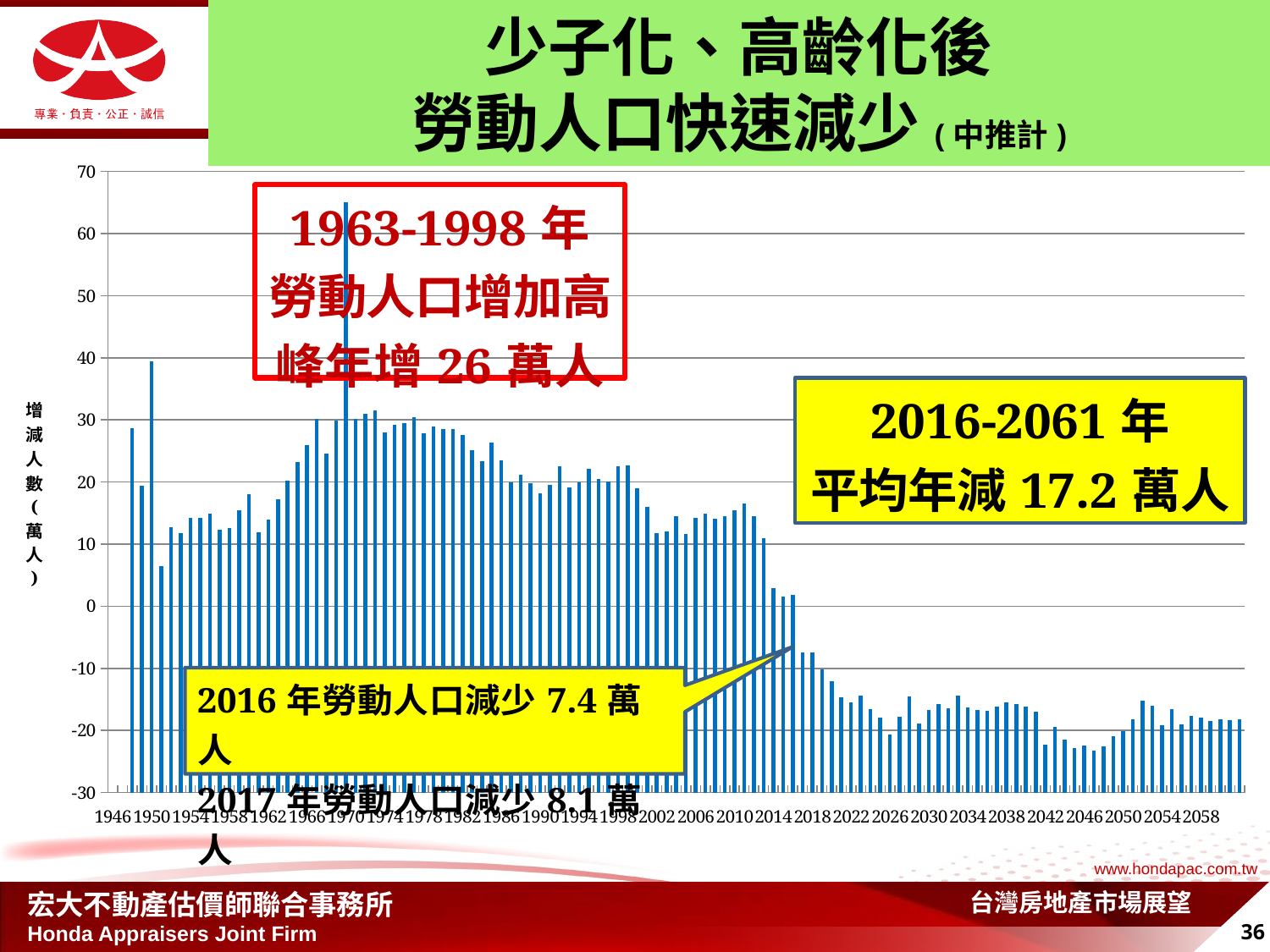
Is the value for 2030 greater or less than -10? less What is the title of the chart on the slide? 少子化、高齡化後 勞動人口快速減少（中推計） Is the value for 2058 greater or less than 0? less According to the annotation on the chart, what is the average annual decrease in labour population for 2016-2061? 17.2 萬人 What kind of chart is shown on the slide? bar chart What is the label on the vertical axis of the chart? 增減人數（萬人） Which is larger, the value for 1950 or the value for 2050? 1950 Is the value for 1950 greater or less than 30? greater According to the annotation on the chart, what was the peak annual increase in labour population during 1963-1998? 26 萬人 Do the values generally rise or fall from 2006 to 2020? fall According to the callout on the chart, by how much did the labour population decrease in 2017? 8.1 萬人 According to the callout on the chart, by how much did the labour population decrease in 2016? 7.4 萬人